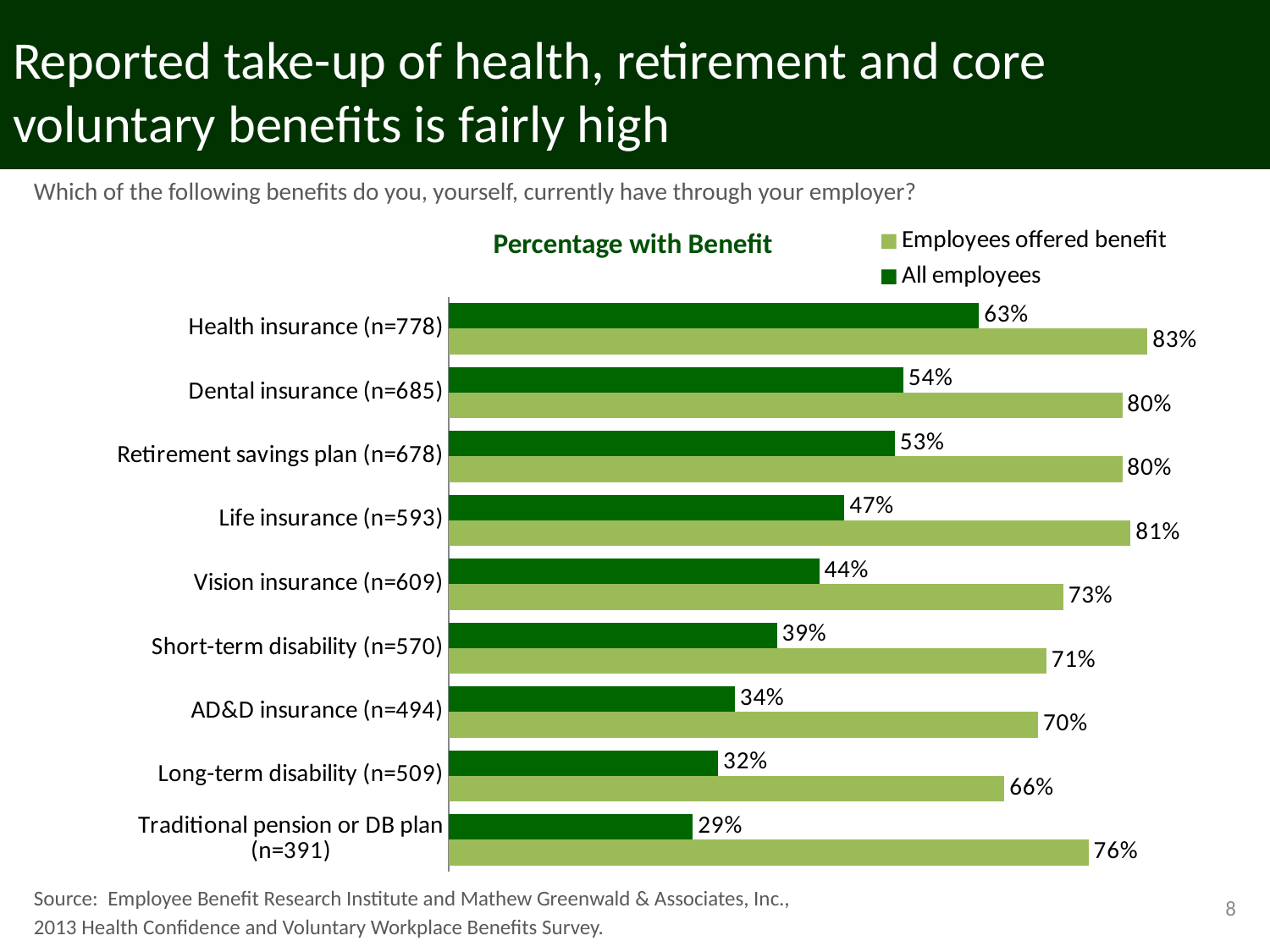
Which category has the highest value in the Employees offered benefit series? Health insurance (n=778) Which category has the lowest value in the All employees series? Traditional pension or DB plan (n=391) Which is larger for Short-term disability (n=570): the All employees value or the Employees offered benefit value? Employees offered benefit What is the title of the chart? Percentage with Benefit What is the difference between the Employees offered benefit and All employees values for Life insurance (n=593)? 34% Which series is shown in dark green? All employees What kind of chart is shown on the slide? Bar chart How many benefit categories are shown in the chart? 9 What percentage of employees offered the benefit have a traditional pension or DB plan (n=391)? 76% What percentage of all employees have health insurance (n=778)? 63% How many series does the legend list? 2 What is the value for Vision insurance (n=609) in the All employees series? 44%